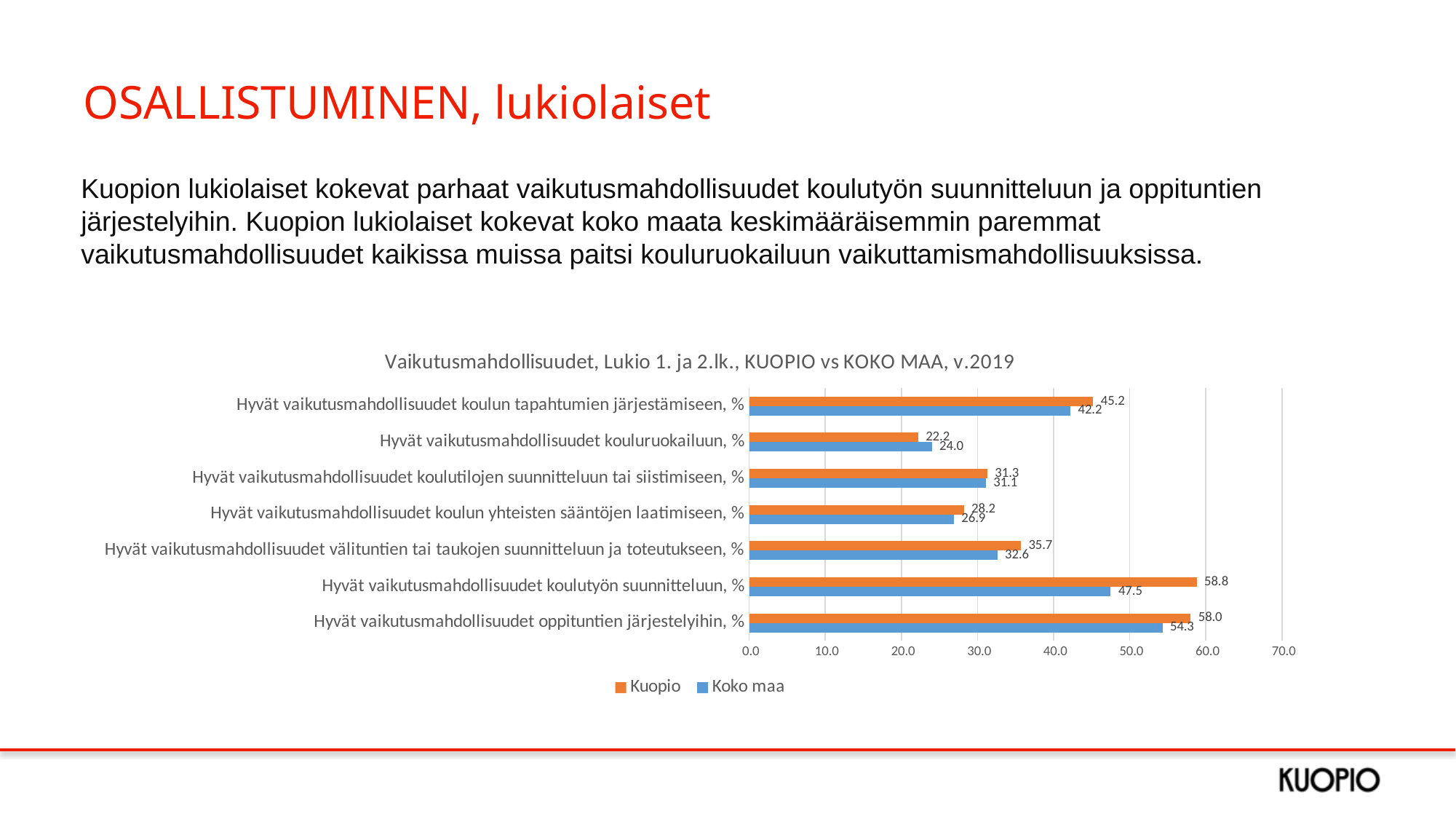
Is the Kuopio value for "Hyvät vaikutusmahdollisuudet välituntien tai taukojen suunnitteluun ja toteutukseen, %" greater or less than 30.0? greater Which category has the highest Kuopio value? Hyvät vaikutusmahdollisuudet koulutyön suunnitteluun, % Which category has the highest Koko maa value? Hyvät vaikutusmahdollisuudet oppituntien järjestelyihin, % What is the Kuopio value for "Hyvät vaikutusmahdollisuudet koulutyön suunnitteluun, %"? 58.8 How many categories are shown in the chart? 7 Which category has the lowest Kuopio value? Hyvät vaikutusmahdollisuudet kouluruokailuun, % What type of chart is shown on the slide? Bar chart How many series does the legend list? 2 What is the difference between the Kuopio and Koko maa values for "Hyvät vaikutusmahdollisuudet koulutyön suunnitteluun, %"? 11.3 For "Hyvät vaikutusmahdollisuudet kouluruokailuun, %", which is larger: Kuopio or Koko maa? Koko maa What is the Koko maa value for "Hyvät vaikutusmahdollisuudet kouluruokailuun, %"? 24.0 What is the Koko maa value for "Hyvät vaikutusmahdollisuudet oppituntien järjestelyihin, %"? 54.3